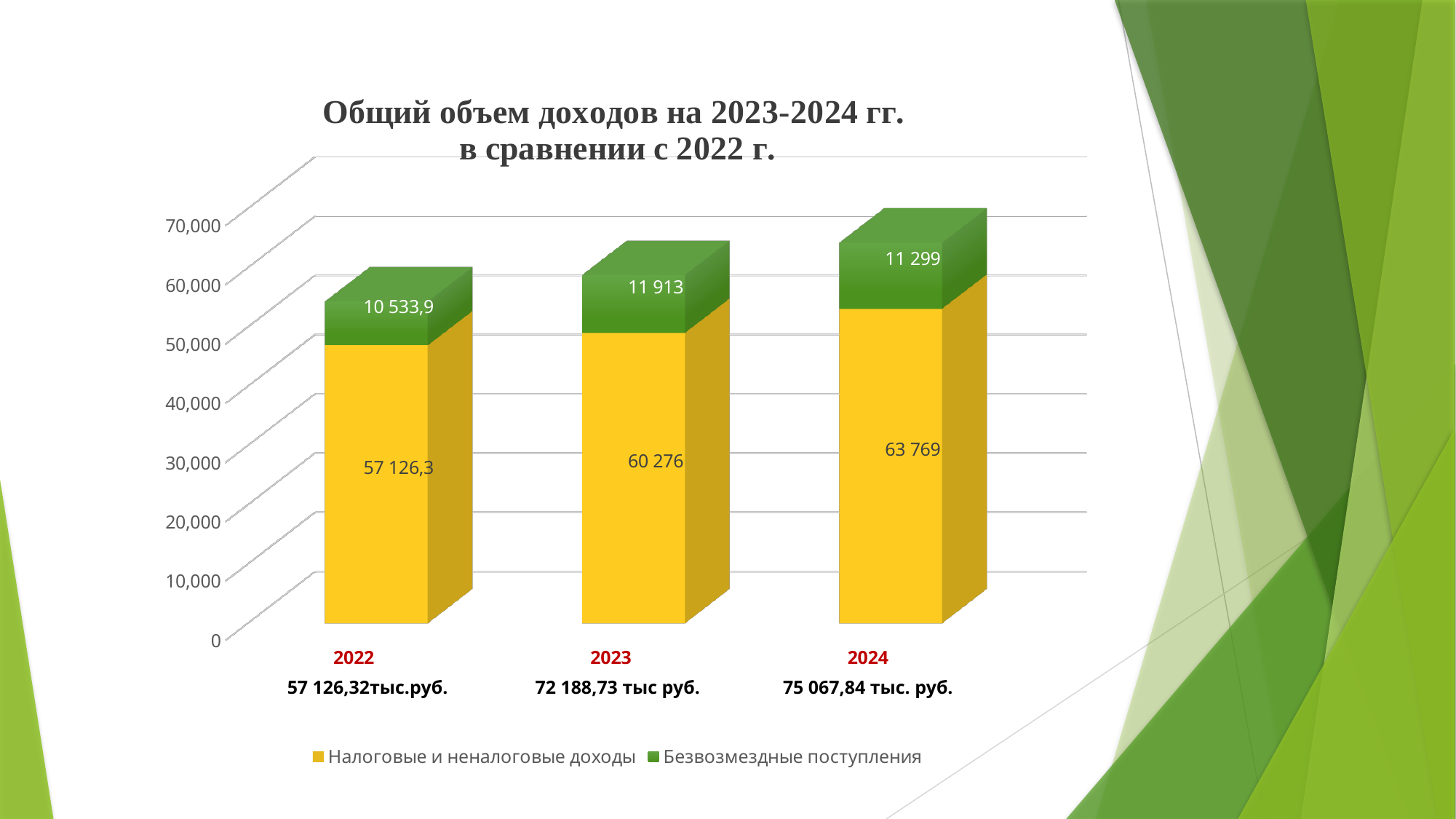
Which year has the larger value for Безвозмездные поступления, 2022 or 2024? 2024 What is the value of Безвозмездные поступления for 2023? 11 913 Which year has the highest value for Налоговые и неналоговые доходы? 2024 How many years are shown on the x axis? 3 Do the values for Налоговые и неналоговые доходы rise or fall from 2022 to 2024? rise How many series does the legend list? 2 What is the difference between the Налоговые и неналоговые доходы values for 2024 and 2023? 3 493 What is the value of Налоговые и неналоговые доходы for 2022? 57 126,3 What total amount is printed below the 2023 bar? 72 188,73 тыс руб. What is the value of Налоговые и неналоговые доходы for 2024? 63 769